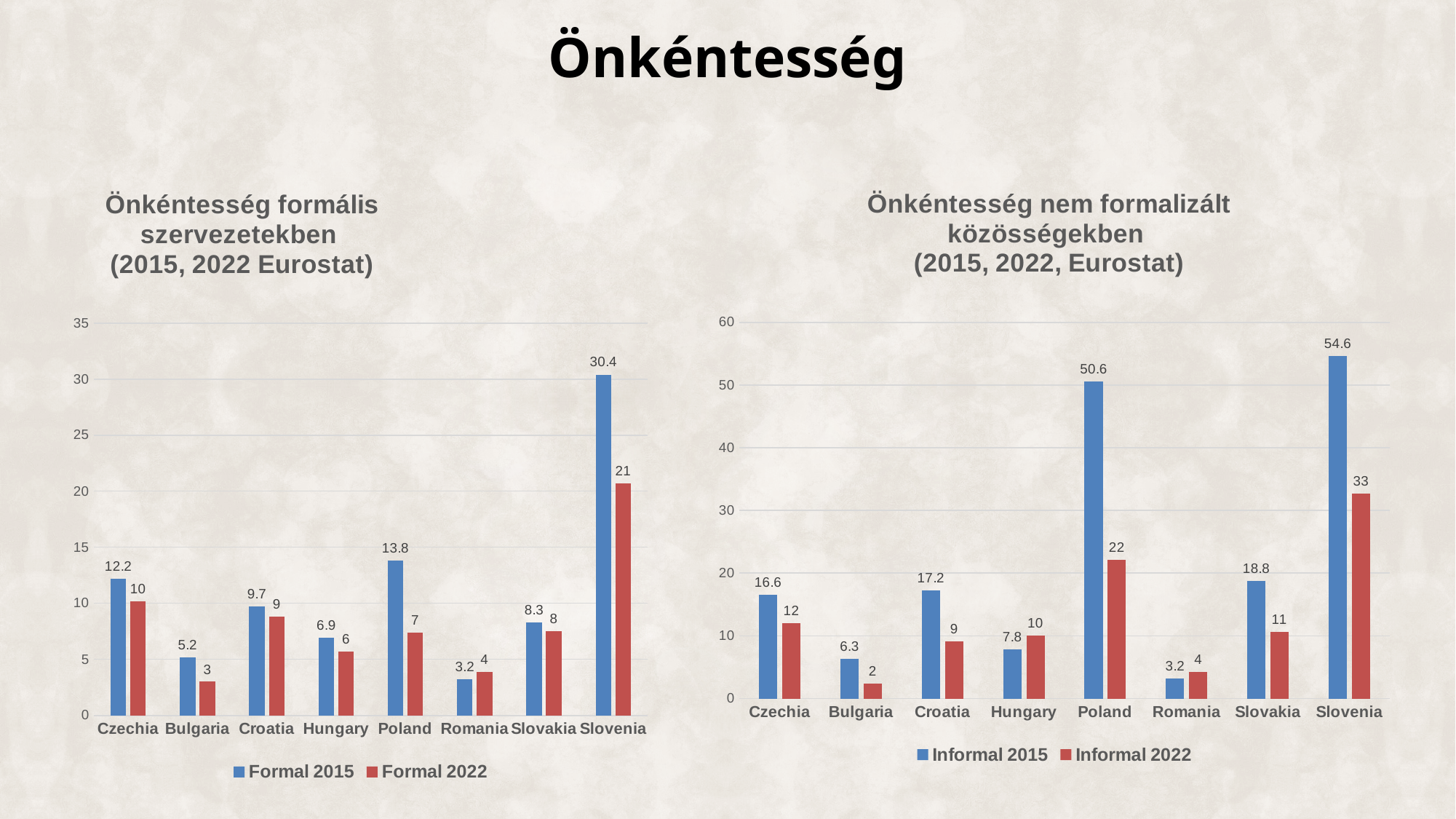
In the right chart (Önkéntesség nem formalizált közösségekben), which country has the highest Informal 2015 value? Slovenia In the right chart (Önkéntesség nem formalizált közösségekben), what is the Informal 2015 value for Poland? 50.6 What kind of chart is the right chart (Önkéntesség nem formalizált közösségekben)? Bar chart In the left chart (Önkéntesség formális szervezetekben), what is the Formal 2015 value for Poland? 13.8 In the left chart (Önkéntesség formális szervezetekben), is the Formal 2015 value for Slovenia greater or less than 25? greater In the left chart (Önkéntesség formális szervezetekben), what is the difference between the Formal 2015 and Formal 2022 values for Slovenia? 9.4 In the right chart (Önkéntesség nem formalizált közösségekben), what is the difference between the Informal 2015 and Informal 2022 values for Poland? 28.6 In the right chart (Önkéntesség nem formalizált közösségekben), which is larger for Hungary: the Informal 2015 value or the Informal 2022 value? Informal 2022 How many countries are shown on the x axis of the right chart (Önkéntesség nem formalizált közösségekben)? 8 In the left chart (Önkéntesség formális szervezetekben), which country has the lowest Formal 2022 value? Bulgaria In the left chart (Önkéntesség formális szervezetekben), what is the Formal 2022 value for Slovenia? 21 How many series does the legend of the left chart (Önkéntesség formális szervezetekben) list? 2